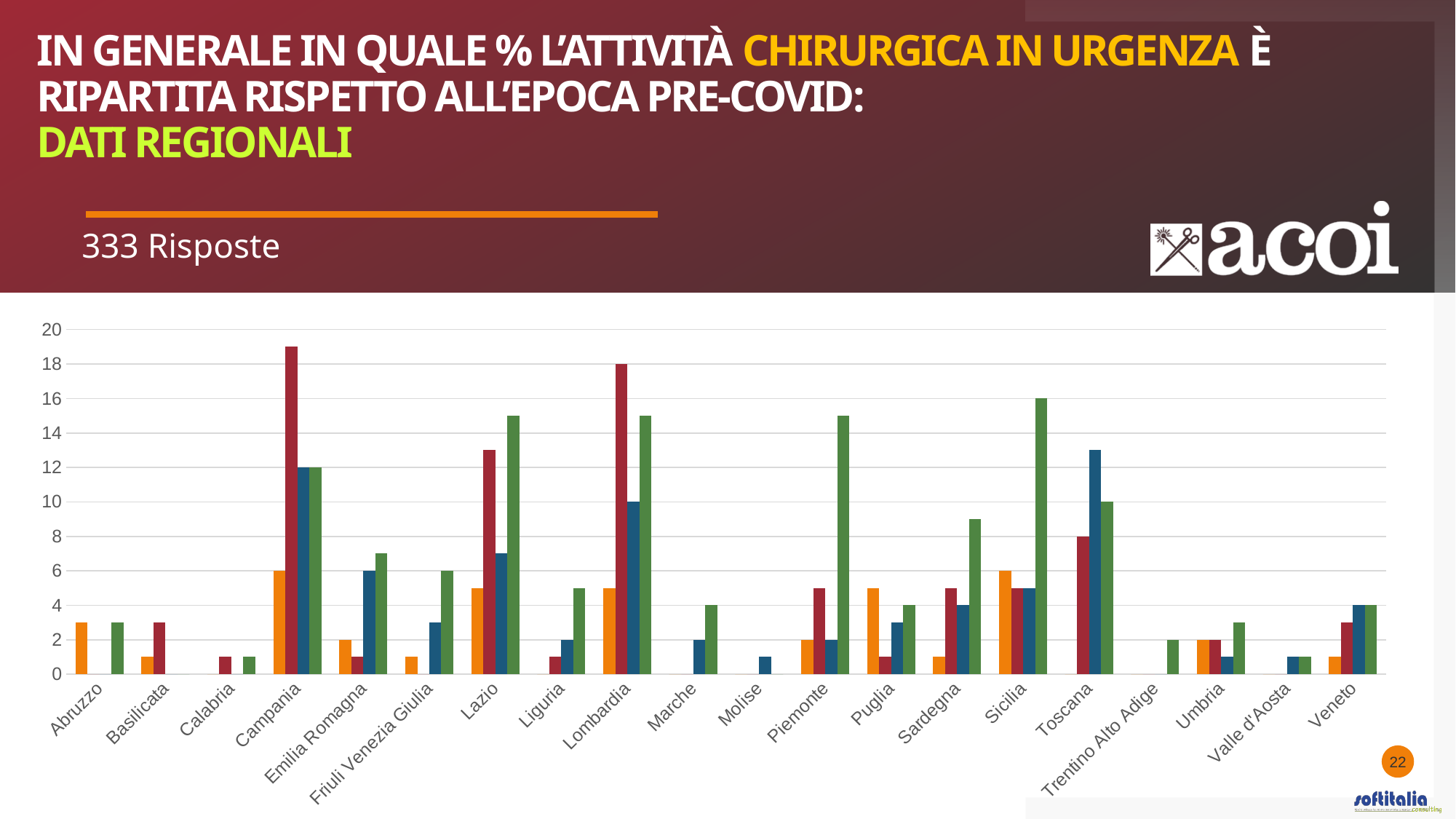
What kind of chart is shown on the slide? bar chart What is the difference between the red bar and the blue bar for Lombardia? 8 What is the value of the orange bar for Campania? 6 How many responses does the slide say the chart is based on? 333 Risposte For Lazio, which is larger: the red bar or the green bar? the green bar Which region has the tallest red bar? Campania Is the value of the green bar for Piemonte greater or less than 14? greater How many regions are listed along the x axis of the chart? 20 What is the value of the green bar for Sicilia? 16 What is the value of the red bar for Lombardia? 18 Is the value of the red bar for Campania greater or less than 18? greater What is the value of the green bar for Toscana? 10